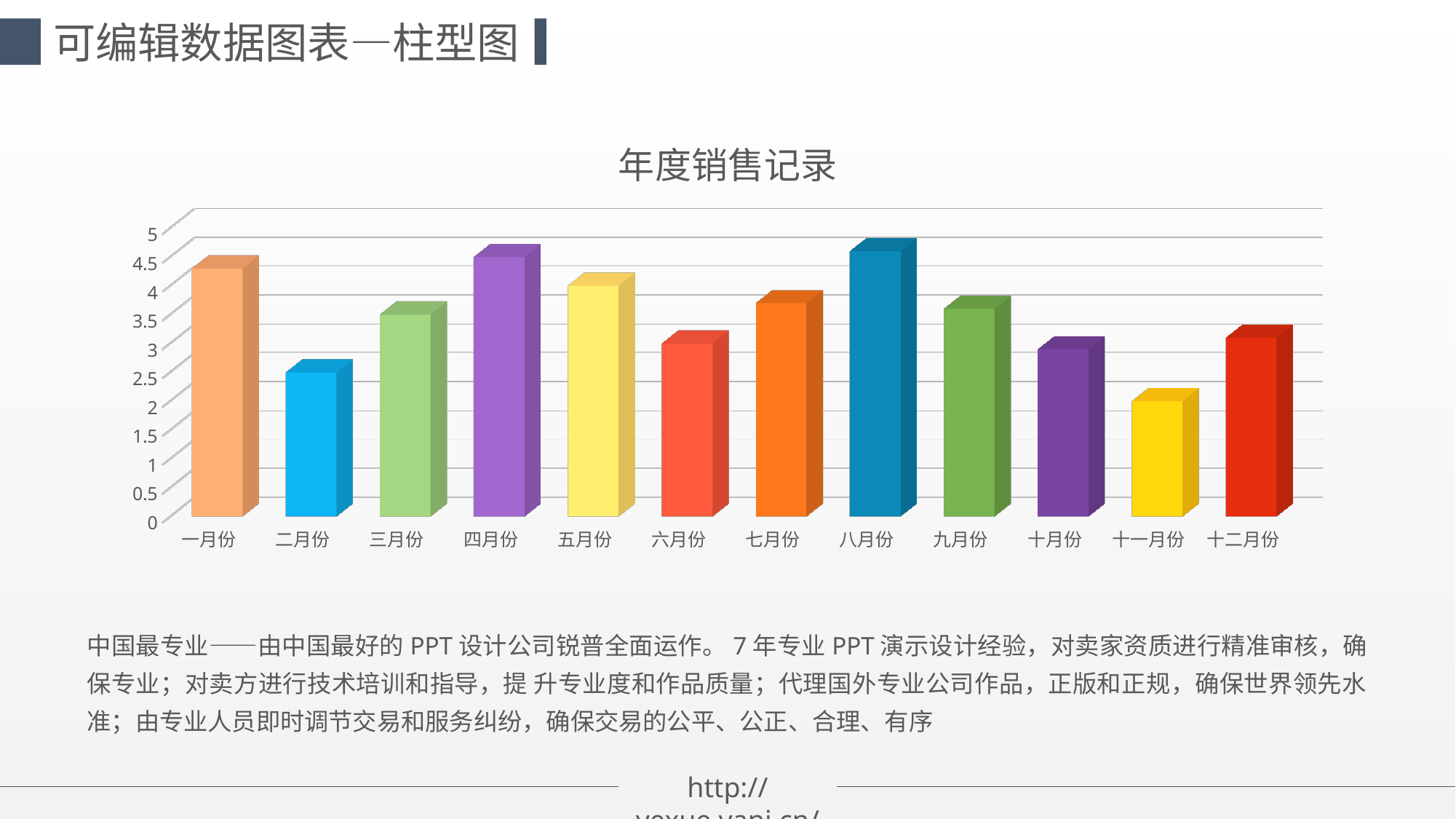
Is the value for 六月份 greater or less than 3.5? less Is the value for 十一月份 greater or less than 2.5? less Is the value for 八月份 greater or less than 4? greater What kind of chart is shown on the slide? Bar chart How many months (categories) are plotted on the x axis? 12 What is the title of the chart? 年度销售记录 Which is larger, the value for 一月份 or 二月份? 一月份 Which is larger, the value for 五月份 or 六月份? 五月份 Which is larger, the value for 三月份 or 十一月份? 三月份 Which month has the lowest bar? 十一月份